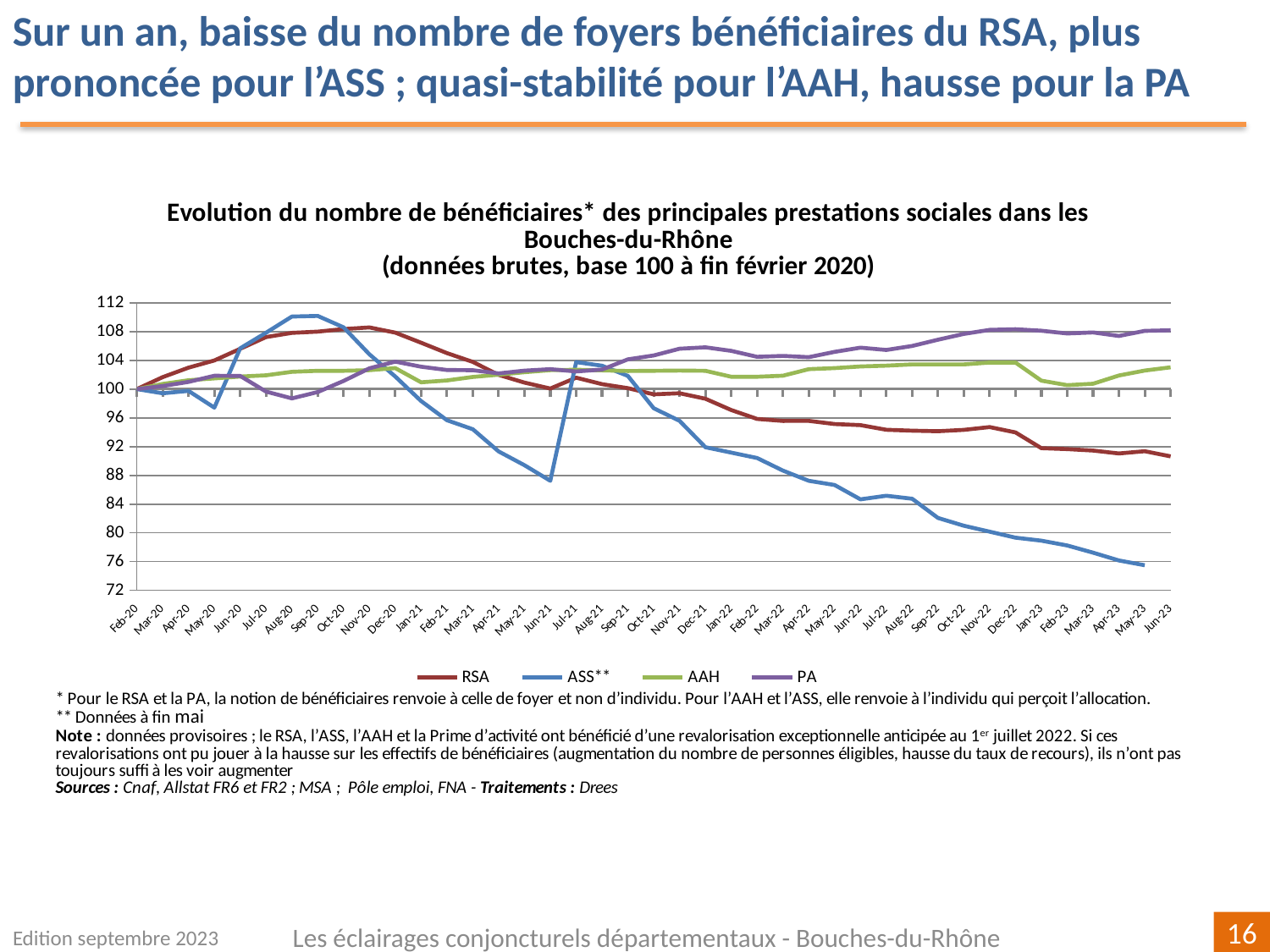
How many series does the legend list? 4 Is the value for PA at Jun-23 greater or less than 104? greater Which series is drawn in blue in the chart? ASS** Does the ASS** series rise or fall between Jan-22 and May-23? fall Is the value for ASS** at May-23 greater or less than 80? less At Jun-23, which is larger, the value for PA or the value for RSA? PA Which series is the lowest at the end of the period shown? ASS** Is the value for RSA at Jun-23 greater or less than 92? less Does the RSA series rise or fall between Nov-20 and Jun-23? fall What kind of chart is shown on the slide? Line chart Which series is the highest at the end of the period shown (Jun-23)? PA